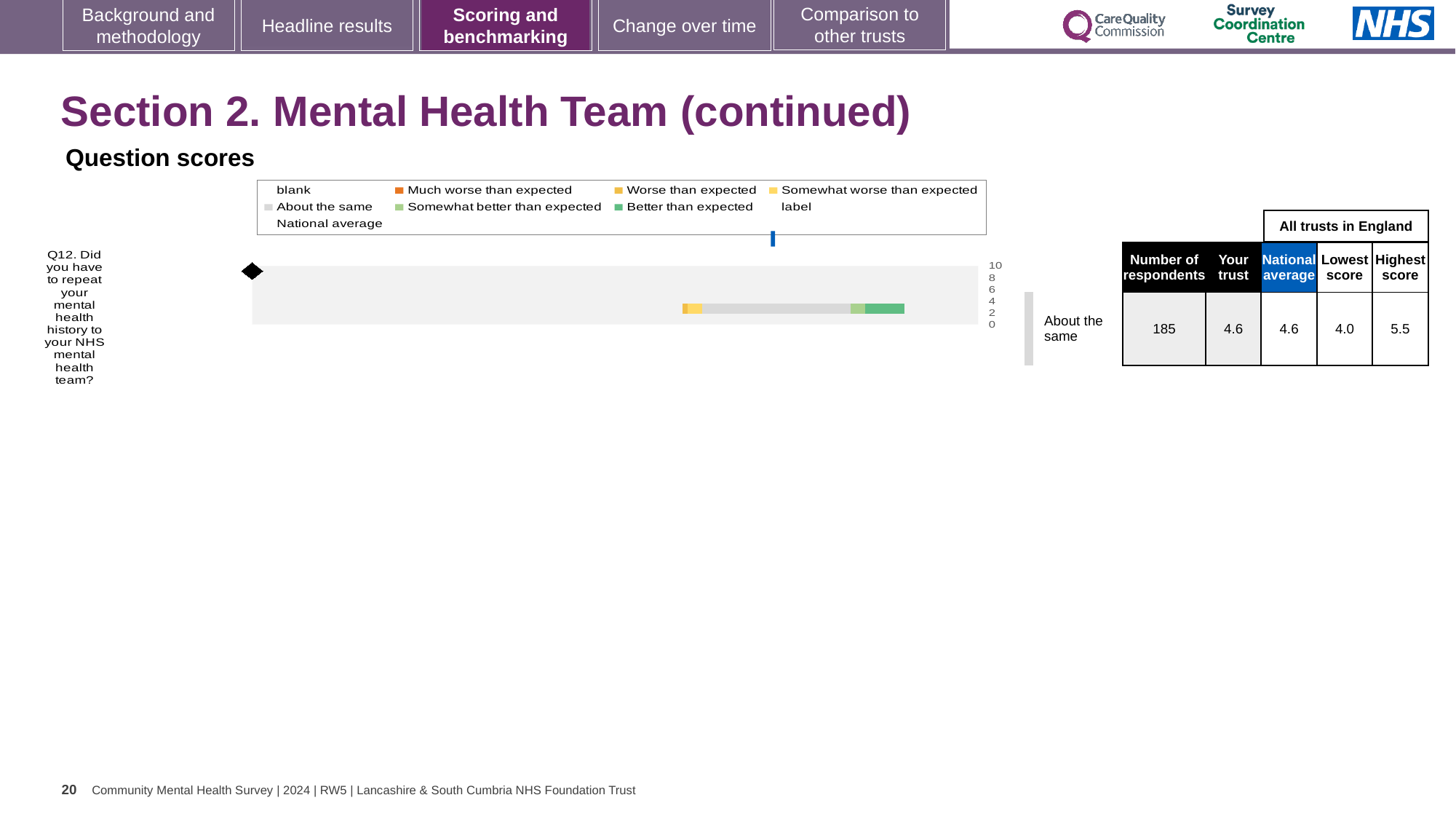
What is the Lowest score among all trusts in England for Q12? 4.0 What is the Highest score among all trusts in England for Q12? 5.5 What is the 'Your trust' score for Q12? 4.6 Which question is plotted in the Question scores chart? Q12. Did you have to repeat your mental health history to your NHS mental health team? What is the difference between the Highest score and the Lowest score for Q12? 1.5 What colour does the legend use for 'Better than expected'? green How many survey questions are plotted in the Question scores chart? 1 By how much does the Highest score exceed the 'Your trust' score for Q12? 0.9 What benchmark category is the trust's Q12 score placed in? About the same What kind of chart is shown under 'Question scores'? bar chart How many respondents answered Q12? 185 What is the National average score for Q12? 4.6